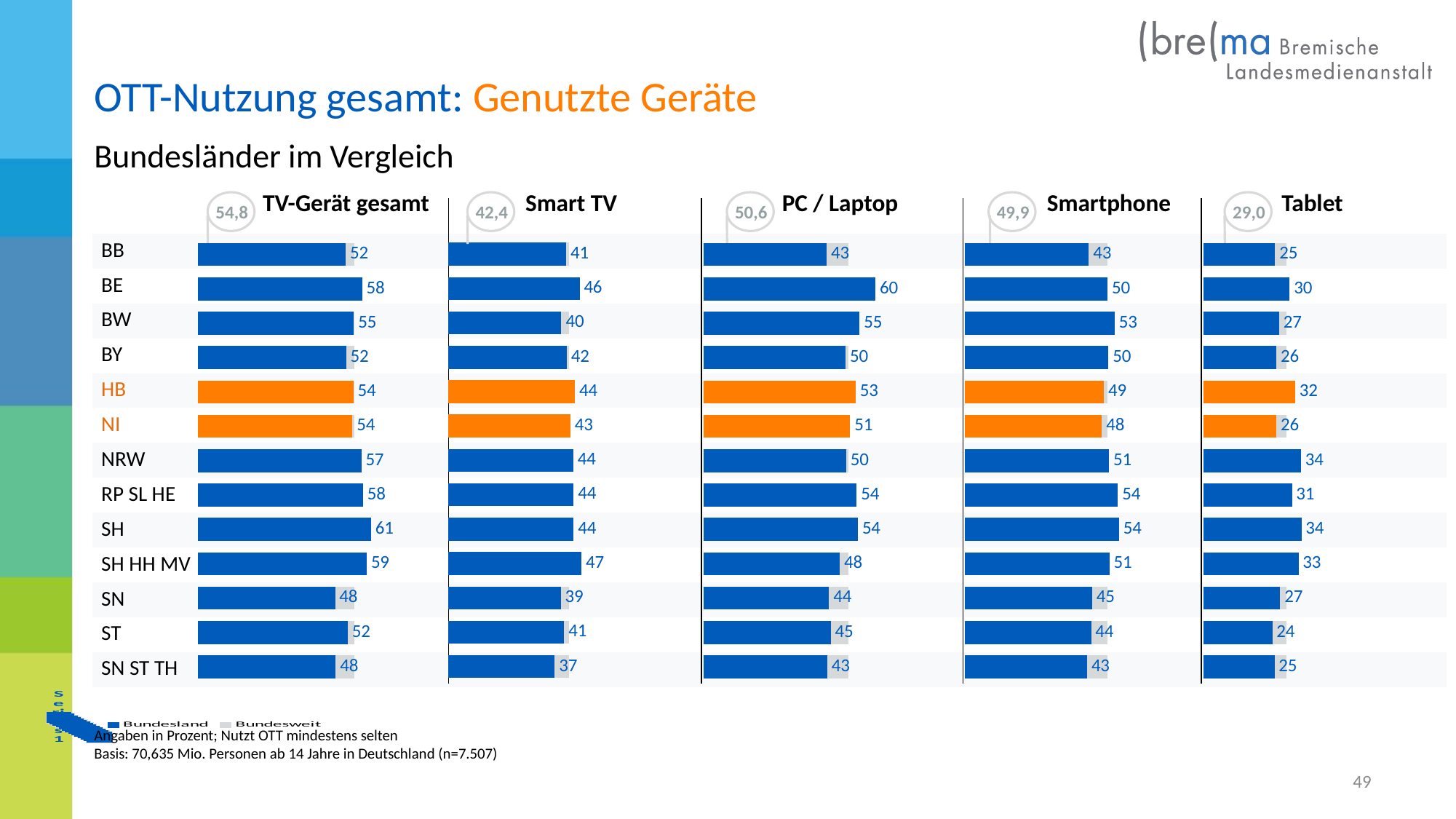
In the Smart TV chart, which Bundesland has the lowest value? SN ST TH In the PC / Laptop chart, what is the difference between the values for BE and BB? 17 In the Tablet chart, what is the value for HB? 32 How many Bundesländer (categories) are listed in each chart? 13 In the TV-Gerät gesamt chart, what is the value for HB? 54 In the PC / Laptop chart, what is the value for BE? 60 In the Tablet chart, which Bundesland has the lowest value? ST What kind of chart is used on this slide? Bar chart What is the Bundesweit (nationwide) value shown for Smart TV? 42,4 Which two Bundesländer are highlighted in orange in the charts? HB and NI In the Smartphone chart, which is larger, the value for BW or the value for SN? BW In the TV-Gerät gesamt chart, which Bundesland has the highest value? SH